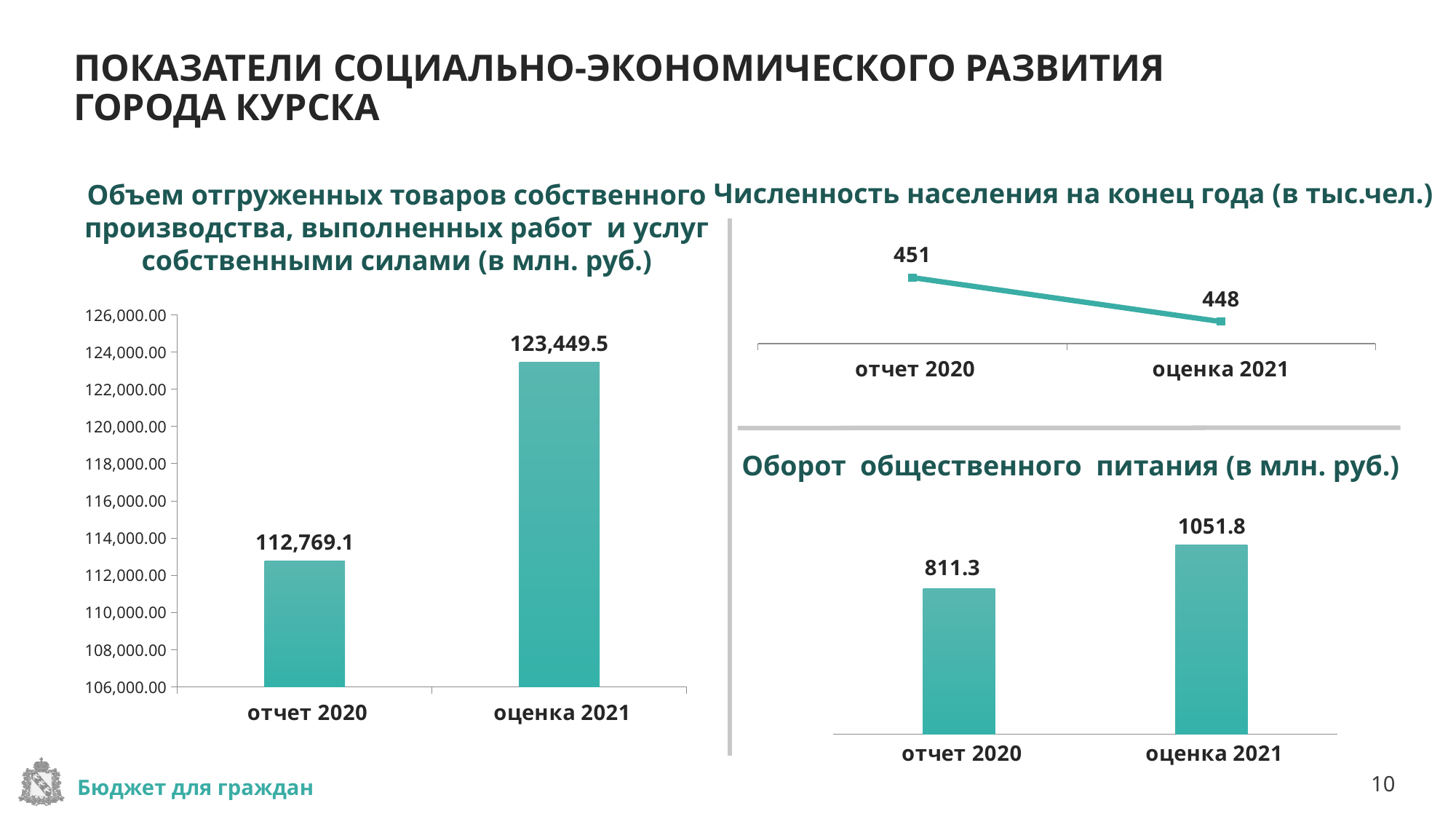
In the chart 'Объем отгруженных товаров собственного производства, выполненных работ и услуг собственными силами (в млн. руб.)', what is the value for 'оценка 2021'? 123,449.5 In the chart 'Оборот общественного питания (в млн. руб.)', which category has the higher value? оценка 2021 What kind of chart is 'Объем отгруженных товаров собственного производства, выполненных работ и услуг собственными силами (в млн. руб.)'? bar chart In the chart 'Оборот общественного питания (в млн. руб.)', what is the value for 'отчет 2020'? 811.3 What kind of chart is 'Численность населения на конец года (в тыс.чел.)'? line chart In the chart 'Оборот общественного питания (в млн. руб.)', what is the difference between 'оценка 2021' and 'отчет 2020'? 240.5 In the chart 'Объем отгруженных товаров собственного производства, выполненных работ и услуг собственными силами (в млн. руб.)', what is the value for 'отчет 2020'? 112,769.1 In the chart 'Объем отгруженных товаров собственного производства, выполненных работ и услуг собственными силами (в млн. руб.)', what is the difference between 'оценка 2021' and 'отчет 2020'? 10,680.4 In the chart 'Оборот общественного питания (в млн. руб.)', what is the value for 'оценка 2021'? 1051.8 In the chart 'Численность населения на конец года (в тыс.чел.)', what is the value for 'отчет 2020'? 451 In the chart 'Численность населения на конец года (в тыс.чел.)', do the values rise or fall from 'отчет 2020' to 'оценка 2021'? fall In the chart 'Численность населения на конец года (в тыс.чел.)', what is the value for 'оценка 2021'? 448